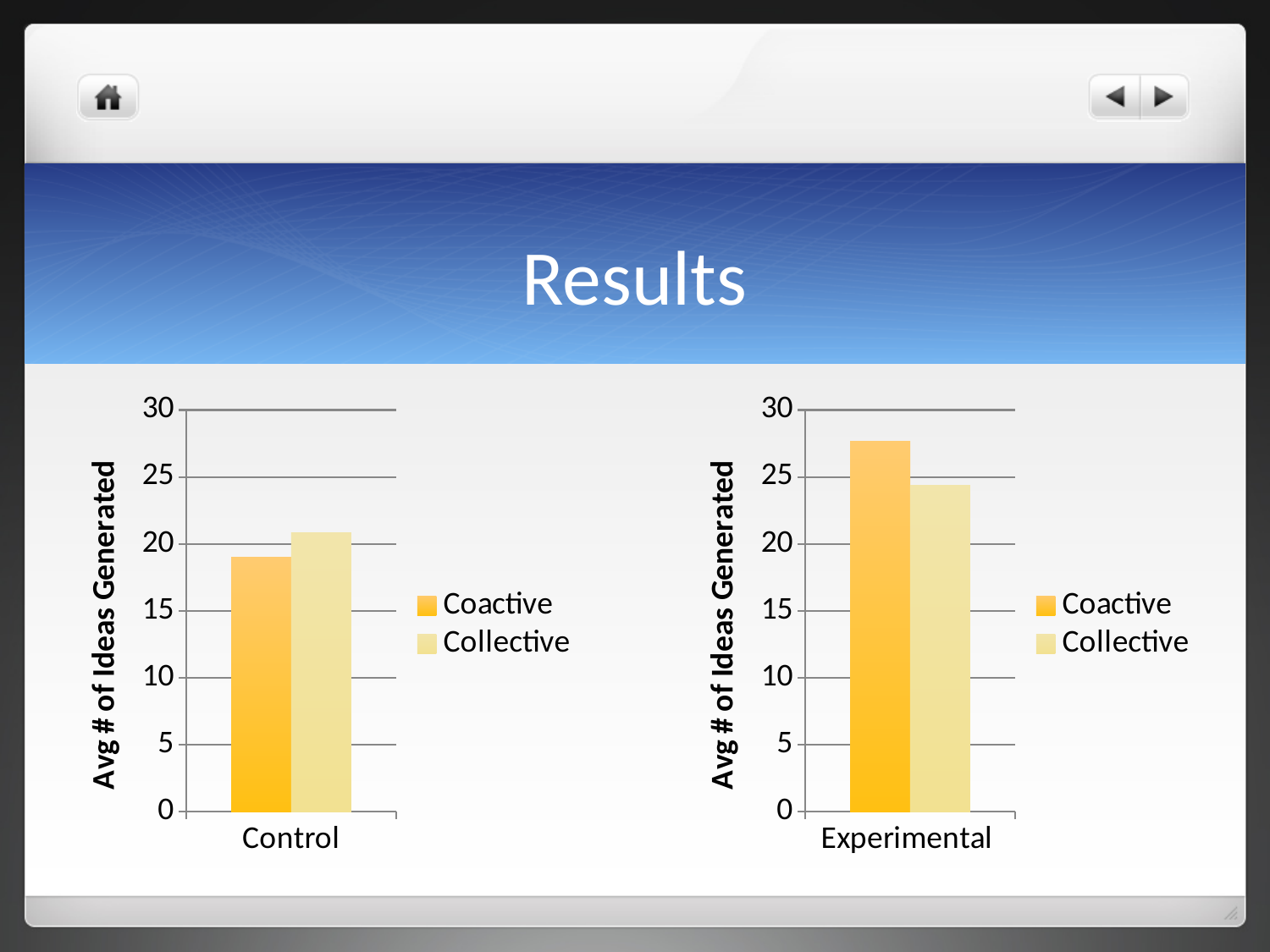
What is the y-axis title of the left chart (Control)? Avg # of Ideas Generated In the left chart (Control), is the value for Collective greater or less than 25? less In the left chart (Control), which series has the taller bar, Coactive or Collective? Collective In the left chart (Control), is the value for Coactive greater or less than 15? greater In the right chart (Experimental), is the value for Collective greater or less than 20? greater In the right chart (Experimental), which series has the taller bar, Coactive or Collective? Coactive In the right chart (Experimental), which series has the lowest value? Collective How many series does the legend of the right chart (Experimental) list? 2 What are the two legend entries in the right chart (Experimental)? Coactive, Collective In the left chart (Control), which series has the highest value? Collective What kind of chart is the left chart (Control)? bar chart